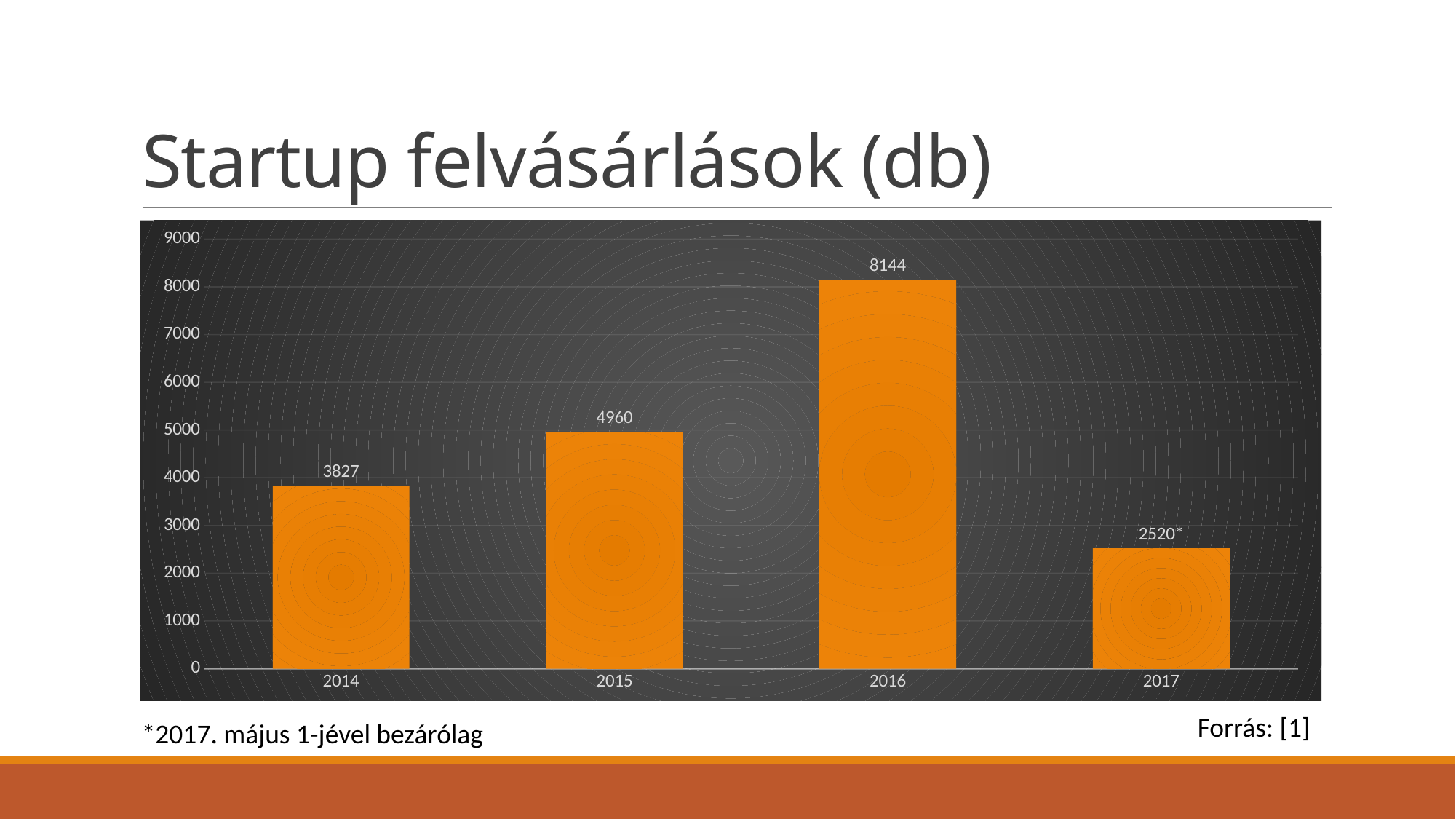
Is the value for 2016 greater or less than 8000? greater Which year has the lowest value? 2017 What is the value shown for 2017? 2520* What is the value for 2016? 8144 What is the difference between the values for 2016 and 2015? 3184 What is the difference between the values for 2015 and 2014? 1133 Which year has the highest value? 2016 How many years are shown on the x axis? 4 What kind of chart is shown on the slide? bar chart What is the title of the slide? Startup felvásárlások (db) What is the value for 2014? 3827 Which is larger, the value for 2014 or the value for 2015? 2015